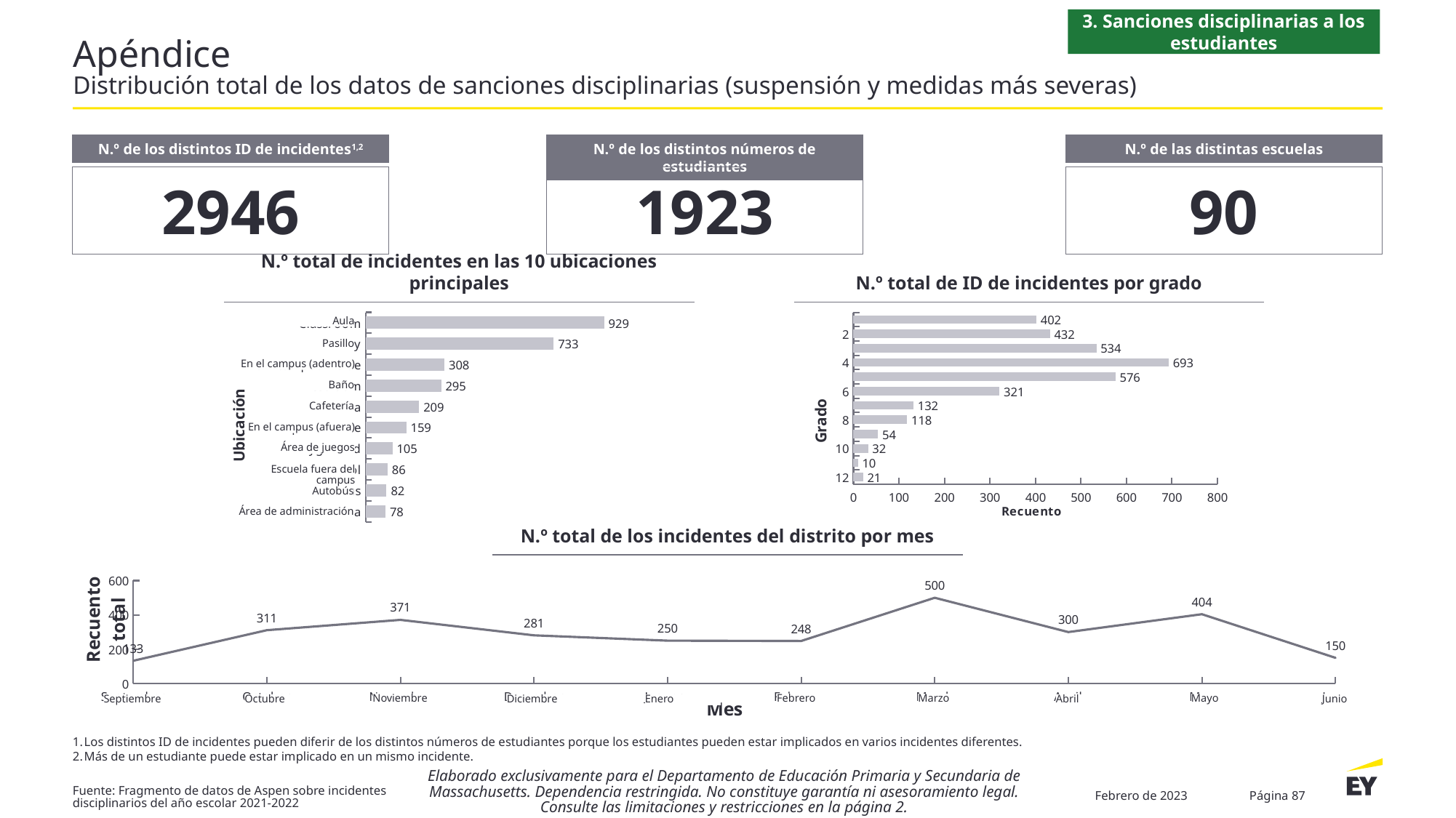
In the chart 'N.º total de ID de incidentes por grado', which grade has the highest number of incident IDs? 4 In the chart 'N.º total de incidentes en las 10 ubicaciones principales', what is the value for Pasillo? 733 In the chart 'N.º total de ID de incidentes por grado', what is the value for grade 4? 693 In the chart 'N.º total de incidentes en las 10 ubicaciones principales', which location has the highest number of incidents? Aula In the chart 'N.º total de los incidentes del distrito por mes', what is the value for Marzo? 500 In the chart 'N.º total de ID de incidentes por grado', which is larger, the value for grade 2 or the value for grade 6? Grade 2 What kind of chart is 'N.º total de los incidentes del distrito por mes'? Line chart In the chart 'N.º total de incidentes en las 10 ubicaciones principales', what is the difference between Aula and Pasillo? 196 In the chart 'N.º total de incidentes en las 10 ubicaciones principales', how many locations are shown? 10 In the chart 'N.º total de incidentes en las 10 ubicaciones principales', which location has the lowest number of incidents? Área de administración In the chart 'N.º total de los incidentes del distrito por mes', what is the difference between Mayo and Junio? 254 In the chart 'N.º total de los incidentes del distrito por mes', which month has the lowest value? Septiembre